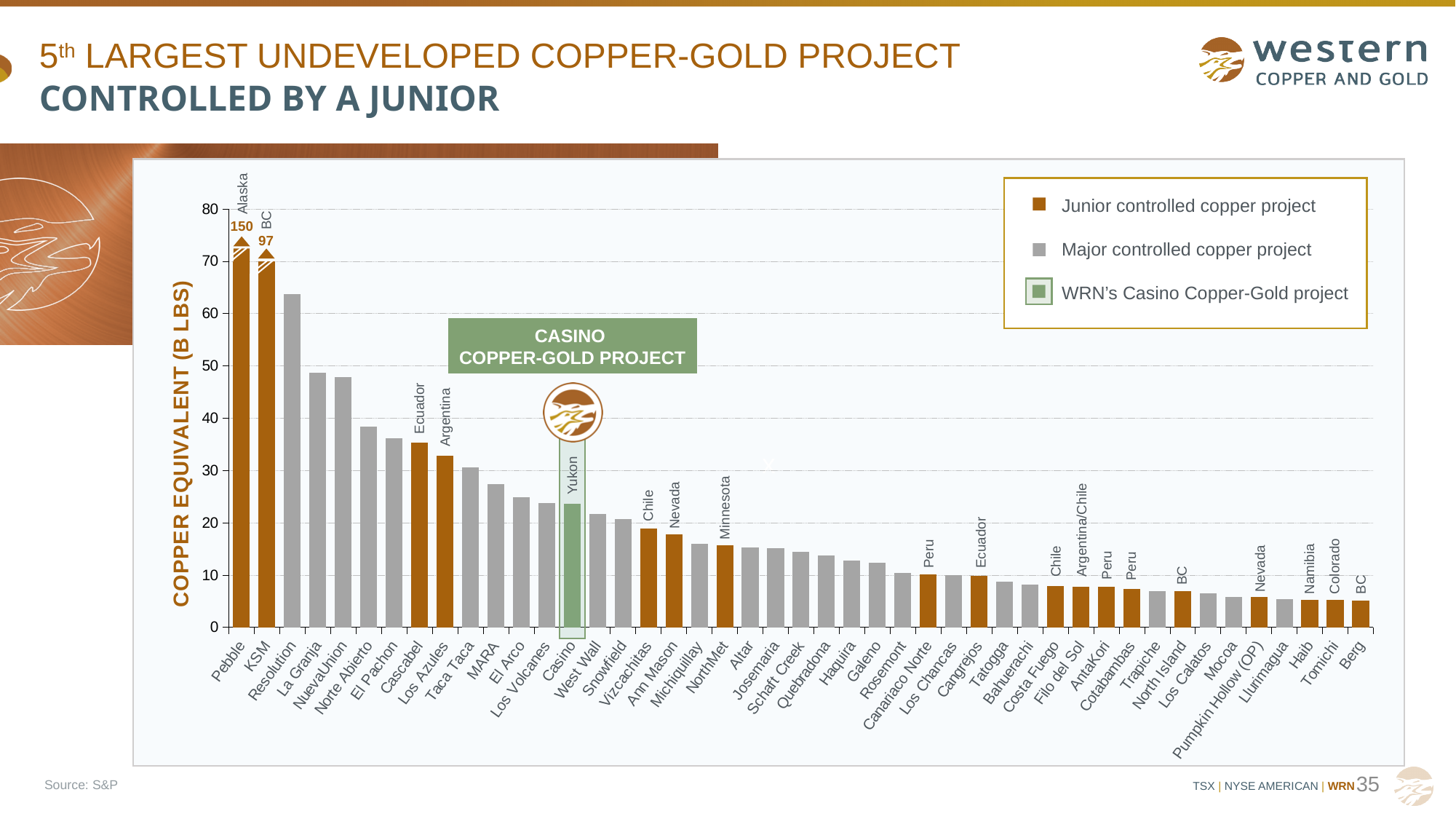
What is the label on the vertical axis of the chart? COPPER EQUIVALENT (B LBS) Is the value for Cascabel greater or less than 30? greater What kind of chart is shown on the slide? bar chart What is the copper equivalent value shown for KSM? 97 Do the values rise or fall moving from left to right along the x axis? fall Is the value for Casino greater or less than 30? less Is the value for Resolution greater or less than 60? greater Which has a larger value, Resolution or La Granja? Resolution What is the difference between the values for Pebble and KSM? 53 Which project has the highest copper equivalent value? Pebble How many entries does the legend list? 3 What is the copper equivalent value shown for Pebble? 150